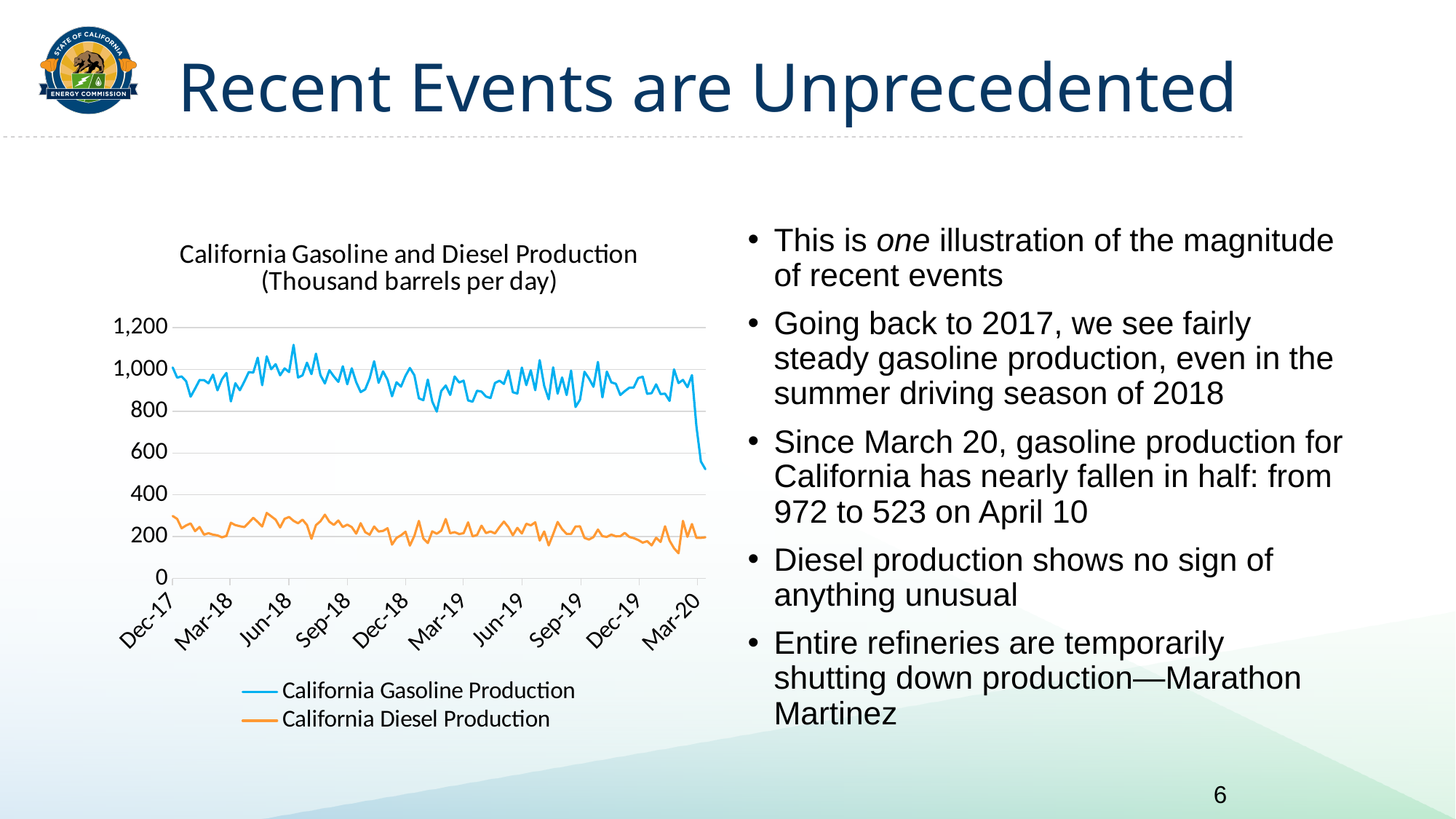
How many date labels are shown on the x axis of the chart? 10 Is the final plotted value for California Gasoline Production (after Mar-20) greater or less than 600? less Which colour is used for the California Gasoline Production line? blue How many series does the chart legend list? 2 Which series has higher values throughout the chart, California Gasoline Production or California Diesel Production? California Gasoline Production Is the value for California Diesel Production around Jun-18 greater or less than 400? less What is the title of the chart? California Gasoline and Diesel Production (Thousand barrels per day) What kind of chart is shown on the slide? line chart Does California Gasoline Production rise or fall sharply at the right end of the chart, after Mar-20? fall Is the value for California Gasoline Production around Jun-18 greater or less than 800? greater What is the first label on the x axis of the chart? Dec-17 What is the highest tick value shown on the y axis of the chart? 1,200